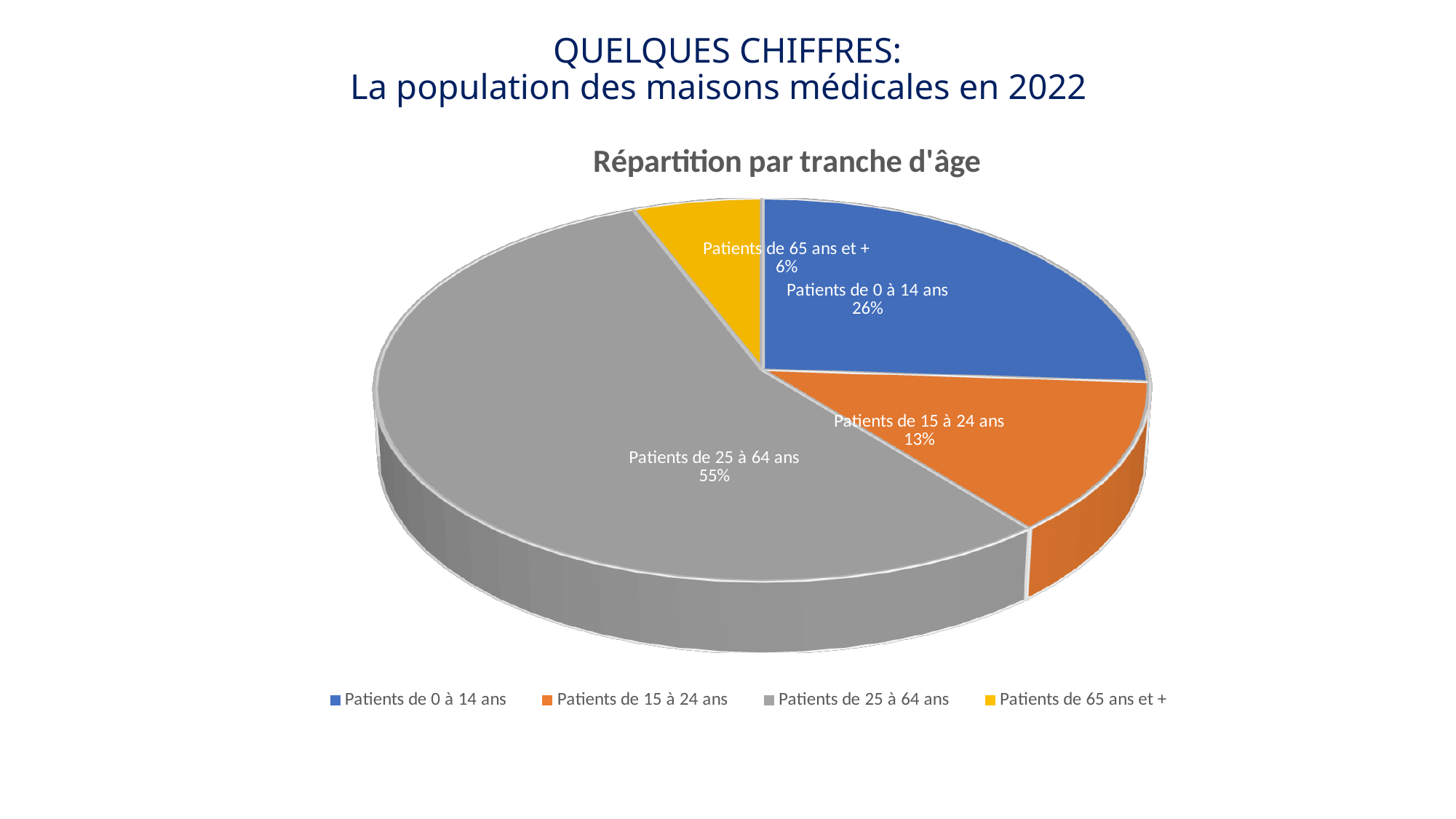
What is the title of the chart? Répartition par tranche d'âge What is the difference in percentage points between 'Patients de 25 à 64 ans' and 'Patients de 0 à 14 ans'? 29 What is the value shown for 'Patients de 65 ans et +'? 6% How many slices does the pie chart have? 4 What kind of chart is shown on the slide? Pie chart What share of the pie does 'Patients de 25 à 64 ans' represent? 55% What is the difference in percentage points between 'Patients de 15 à 24 ans' and 'Patients de 65 ans et +'? 7 Which is larger: the share for 'Patients de 0 à 14 ans' or for 'Patients de 15 à 24 ans'? Patients de 0 à 14 ans What is the value shown for 'Patients de 15 à 24 ans'? 13% Which age group has the smallest share of the pie? Patients de 65 ans et + Which age group has the largest share of the pie? Patients de 25 à 64 ans What is the value shown for 'Patients de 0 à 14 ans'? 26%